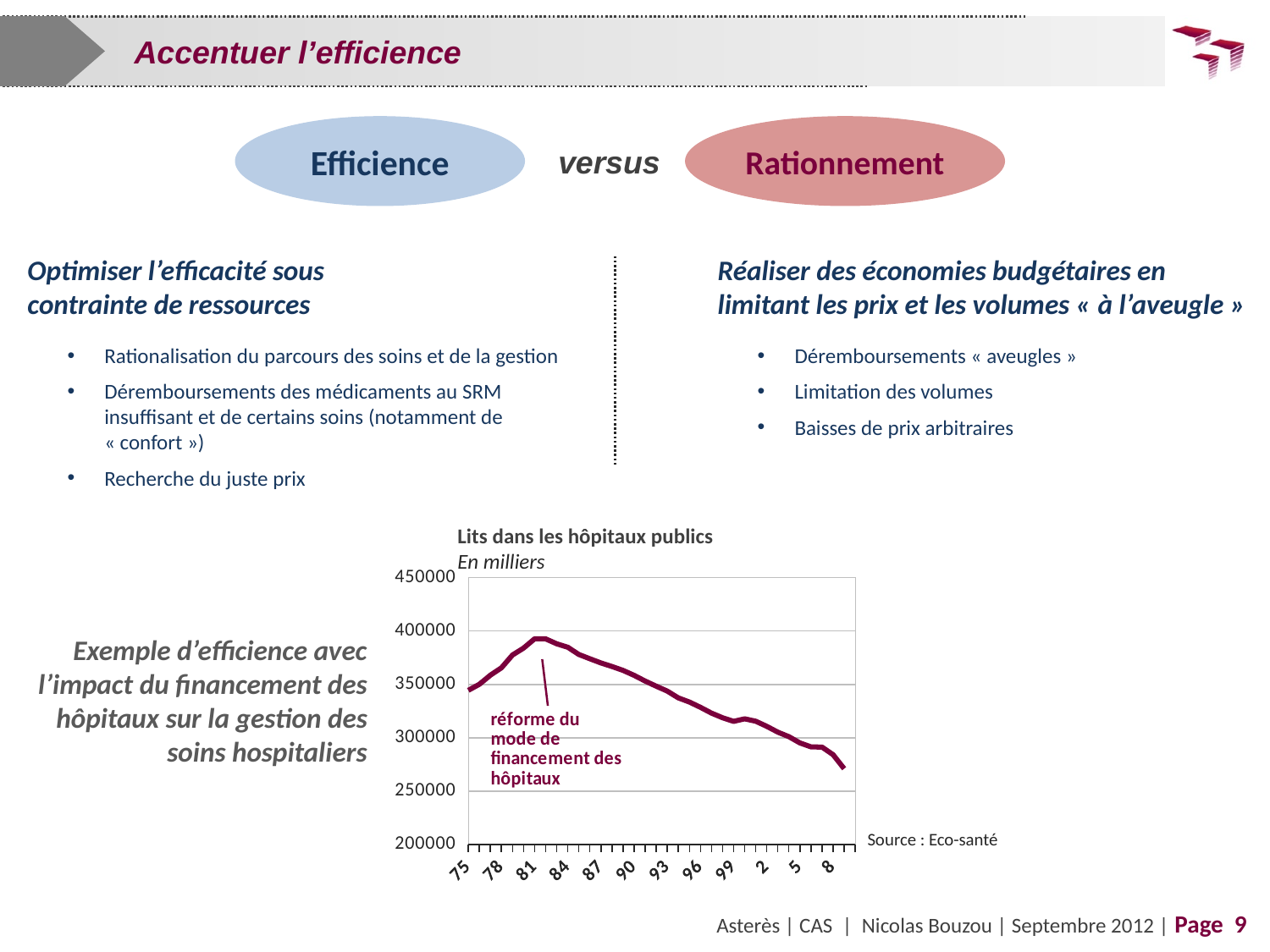
Is the value for 81 greater or less than 350000? greater In which year labelled on the x axis does the number of beds reach its highest point? 81 What unit is indicated under the chart title? En milliers Is the value for 8 greater or less than 300000? less In which year labelled on the x axis is the number of beds lowest? 8 What is the title of the chart? Lits dans les hôpitaux publics Which is larger, the value for 84 or the value for 96? 84 Which is larger, the value for 75 or the value for 8? 75 What kind of chart is shown on the slide? line chart Is the value for 90 greater or less than 300000? greater After the peak around 81, do the values rise or fall along the x axis? fall